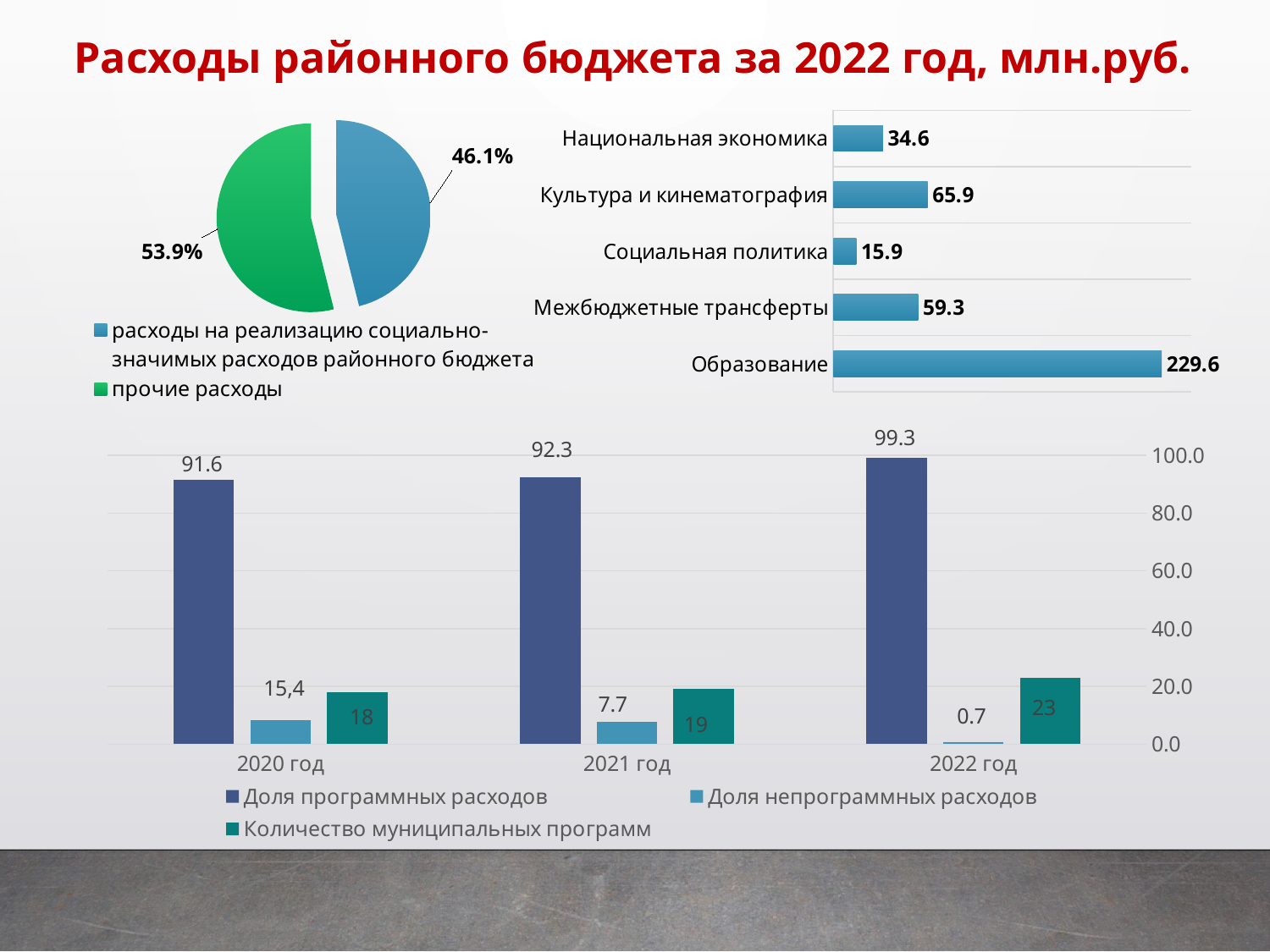
In the top-right bar chart, which category has the lowest value? Социальная политика In the top-right bar chart, which is larger: Национальная экономика or Межбюджетные трансферты? Межбюджетные трансферты In the pie chart on the top left, what share is labelled for прочие расходы? 53.9% In the bottom chart, what is the value of Доля программных расходов for 2022 год? 99.3 In the pie chart on the top left, which slice is larger: the blue one or the green one? the green one (прочие расходы) In the top-right bar chart, how many categories are shown? 5 In the bottom chart, does Доля программных расходов rise or fall from 2020 год to 2022 год? rise In the bottom chart, what is the value of Количество муниципальных программ for 2021 год? 19 In the bottom chart, how many series does the legend list? 3 What kind of chart is the top-right chart? bar chart In the top-right bar chart, what is the difference between Культура и кинематография and Межбюджетные трансферты? 6.6 In the top-right bar chart, what is the value for Образование? 229.6